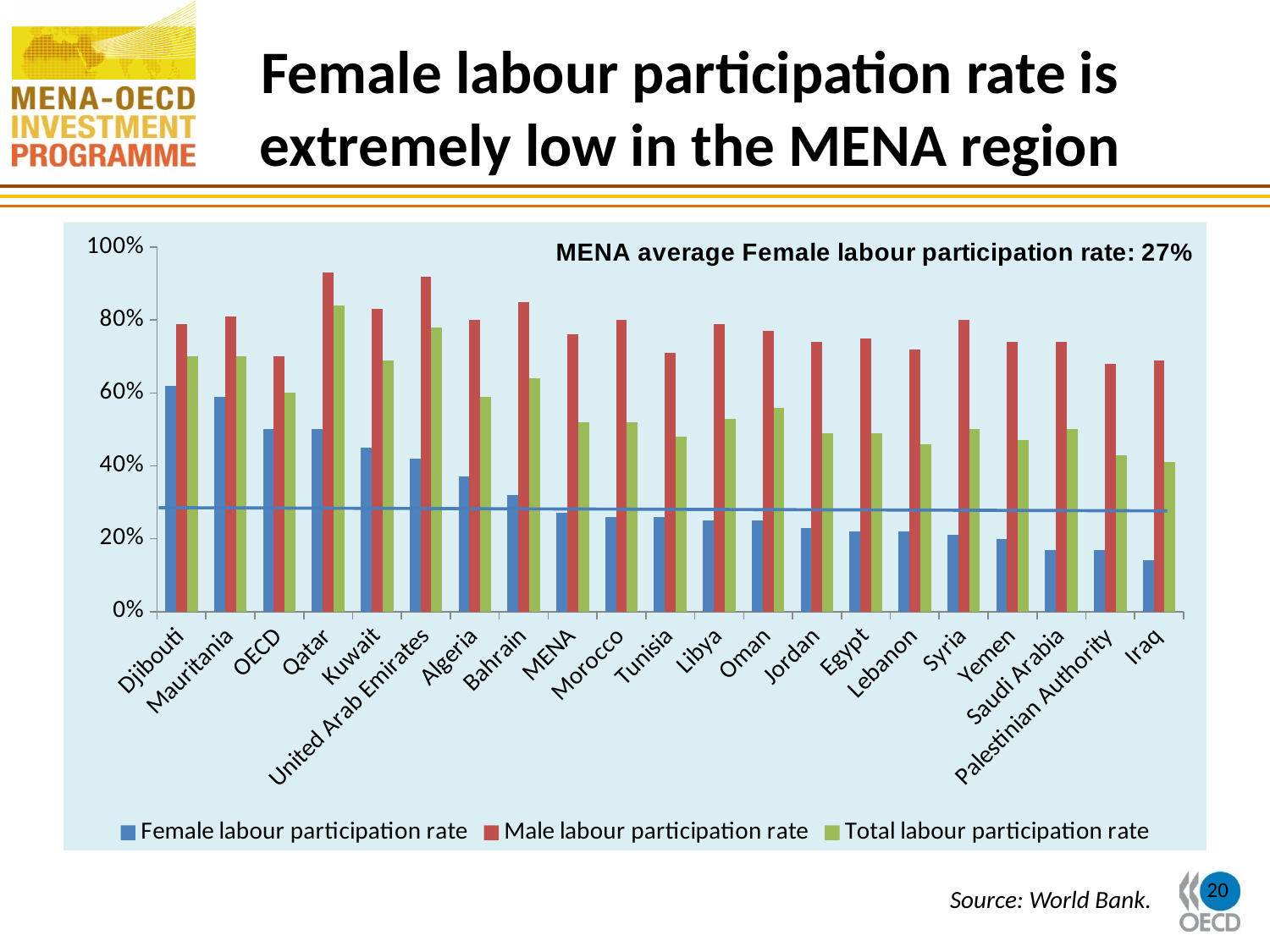
Which is larger, the total labour participation rate for Qatar or for Morocco? Qatar Which category has the lowest female labour participation rate? Iraq What kind of chart is shown on the slide? bar chart Is the total labour participation rate for Kuwait greater or less than 60%? greater What MENA average female labour participation rate is stated on the chart? 27% Do the female labour participation rate bars generally rise or fall from left to right along the x axis? fall How many series does the legend list? 3 Which category has the highest total labour participation rate? Qatar Is the female labour participation rate for Iraq greater or less than 20%? less Is the male labour participation rate for Qatar greater or less than 80%? greater Which category has the highest female labour participation rate? Djibouti How many countries or regions are shown along the x axis? 21